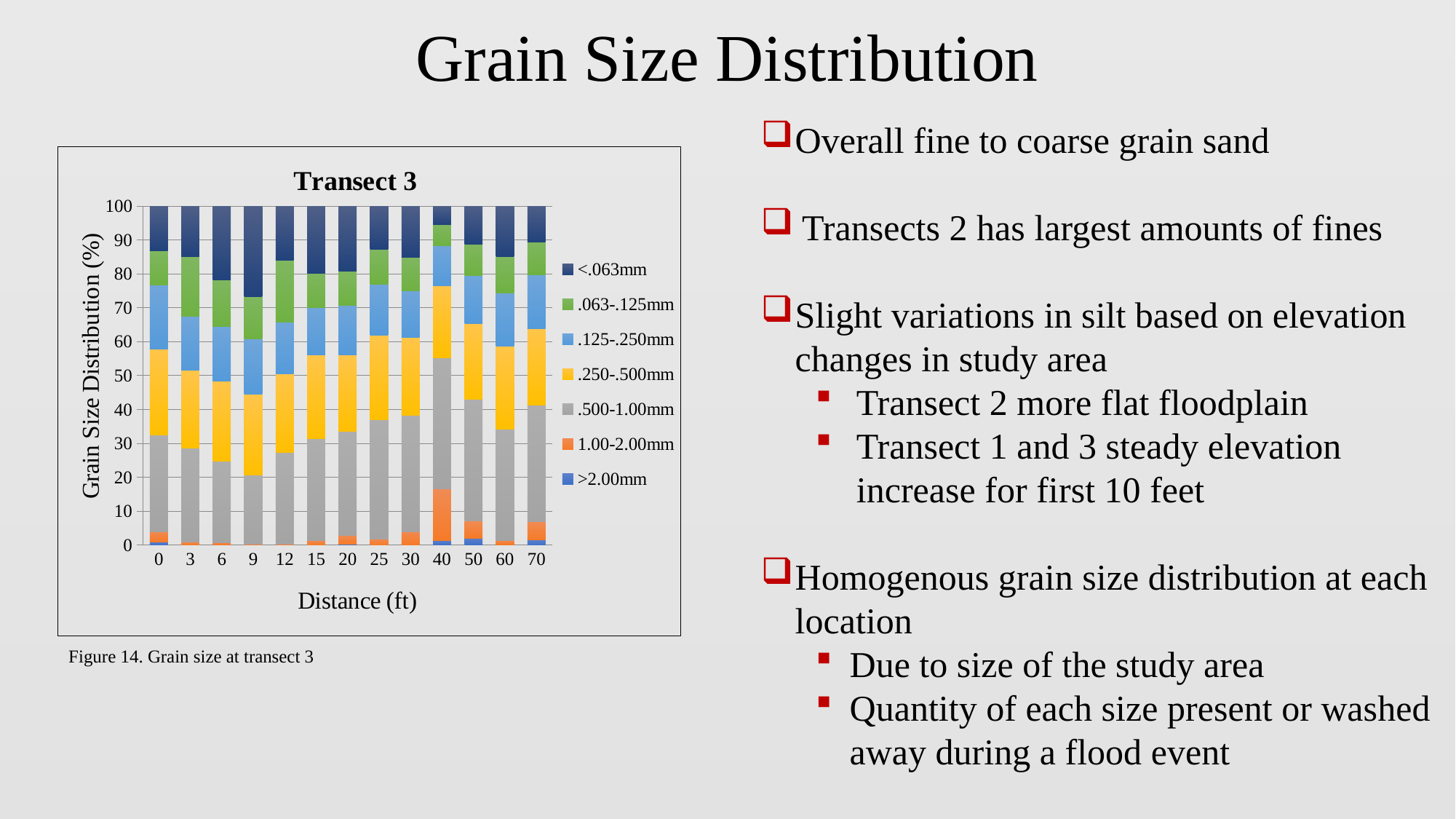
What is the total of the stacked bar at 0 ft? 100 What kind of chart is shown on the slide? Stacked bar chart How many series does the chart's legend list? 7 At which distance is the 1.00-2.00mm segment the largest? 40 How many distance categories are plotted along the x axis? 13 At which distance is the <.063mm segment the largest? 9 What is the label of the x axis? Distance (ft) At which distance is the .500-1.00mm segment the smallest? 9 Is the 1.00-2.00mm segment larger at 40 ft or at 50 ft? 40 ft What is the title of the chart? Transect 3 Is the value of the 1.00-2.00mm segment at 40 ft greater or less than 10? greater At which distance is the <.063mm segment the smallest? 40